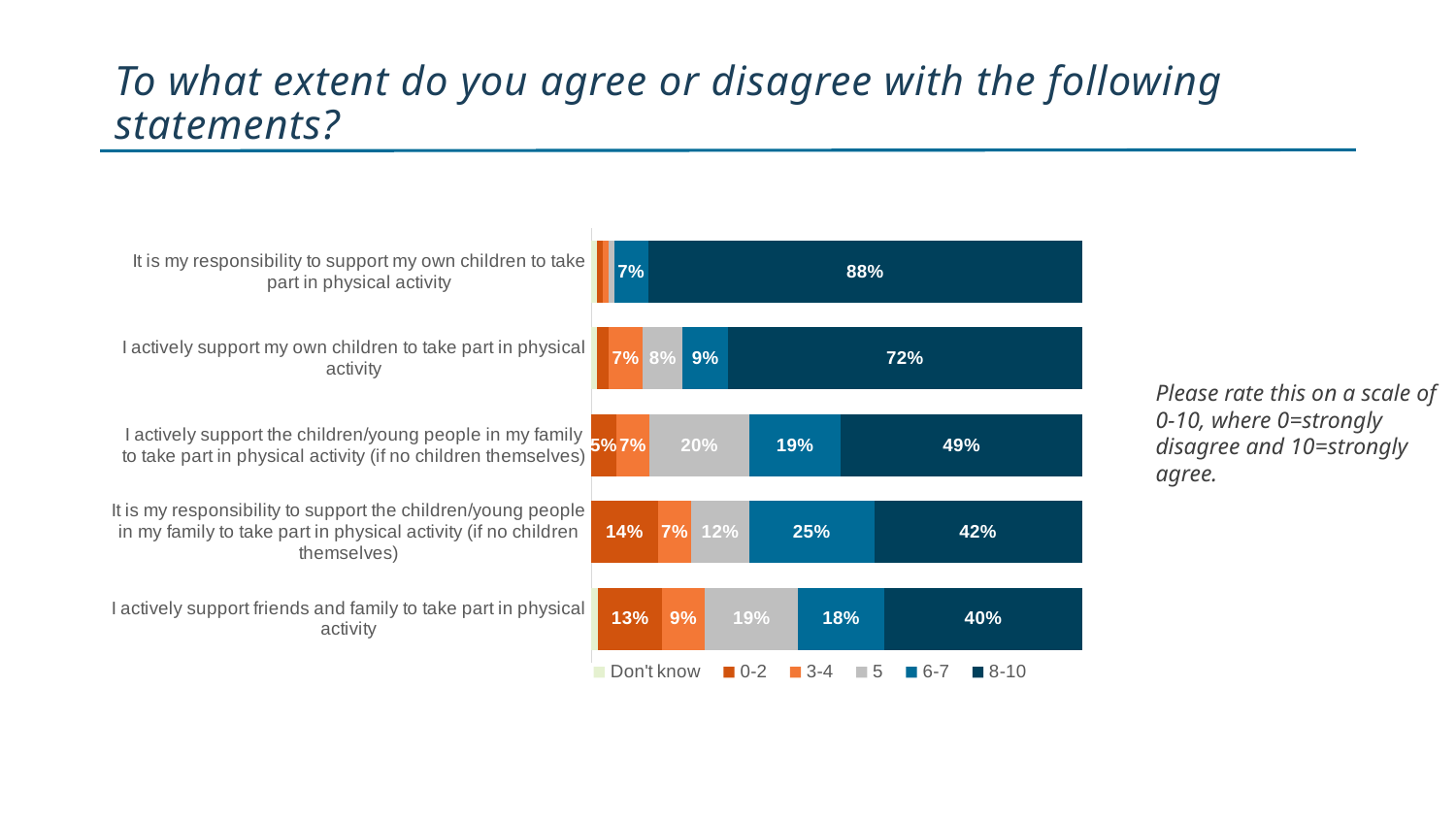
Which legend entry is shown in the darkest blue colour? 8-10 What is the difference between the 8-10 share for "It is my responsibility to support my own children to take part in physical activity" and for "I actively support my own children to take part in physical activity"? 16% What percentage of respondents rated 8-10 for "It is my responsibility to support my own children to take part in physical activity"? 88% Which has a larger 6-7 share: "It is my responsibility to support the children/young people in my family to take part in physical activity (if no children themselves)" or "I actively support friends and family to take part in physical activity"? It is my responsibility to support the children/young people in my family to take part in physical activity (if no children themselves) What percentage of respondents rated 0-2 for "It is my responsibility to support the children/young people in my family to take part in physical activity (if no children themselves)"? 14% Which statement has the lowest share of 8-10 ratings? I actively support friends and family to take part in physical activity How many statements (categories) are plotted in the chart? 5 Which statement has the highest share of 8-10 ratings? It is my responsibility to support my own children to take part in physical activity How many series does the legend list? 6 What percentage of respondents rated 5 for "I actively support friends and family to take part in physical activity"? 19% What percentage of respondents rated 8-10 for "I actively support my own children to take part in physical activity"? 72% What kind of chart is shown on the slide? Stacked bar chart